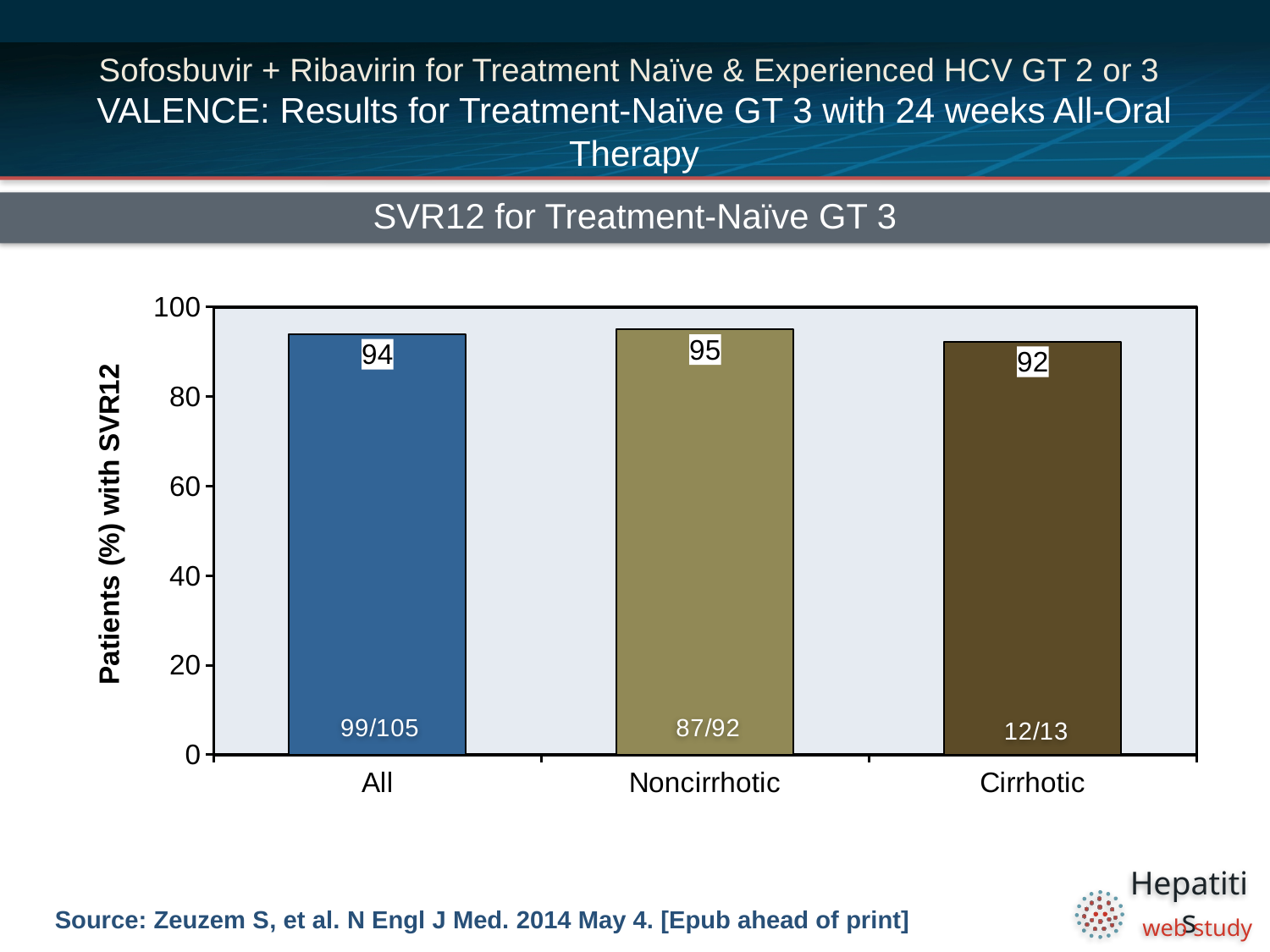
Which group has a larger SVR12 value, All or Cirrhotic? All Is the SVR12 value for the Cirrhotic group greater or less than 80? greater What is the SVR12 value for the Noncirrhotic group? 95 What is the SVR12 value for the All group? 94 Which group has the lowest SVR12 value? Cirrhotic Which group has the highest SVR12 value? Noncirrhotic What is the difference between the SVR12 values for the Noncirrhotic and Cirrhotic groups? 3 What fraction of patients is printed on the Cirrhotic bar? 12/13 How many groups are shown on the x axis of the chart? 3 What kind of chart is shown on the slide? Bar chart What is the title of the chart? SVR12 for Treatment-Naïve GT 3 What is the SVR12 value for the Cirrhotic group? 92